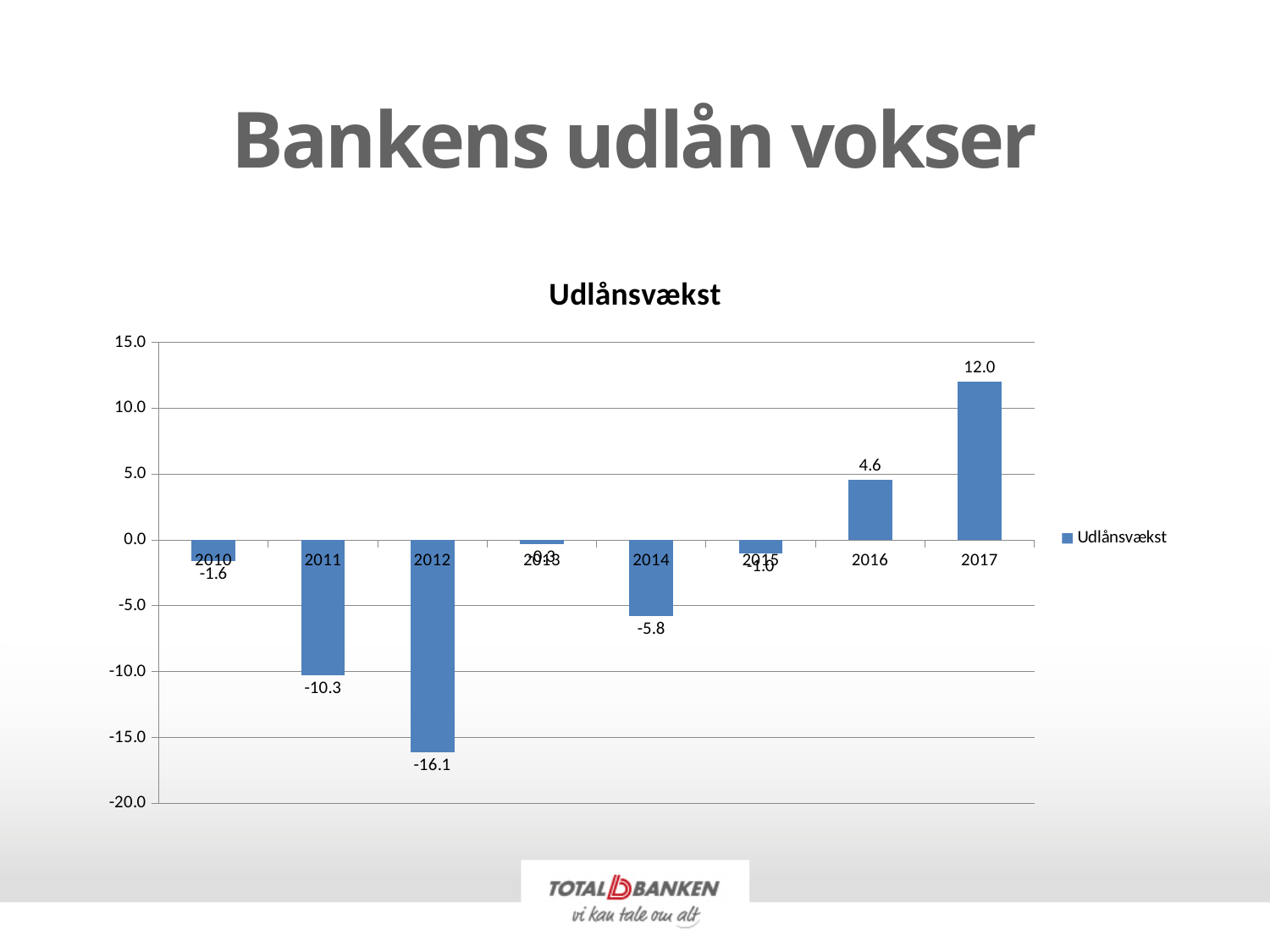
What is the difference between the values for 2017 and 2016 in the Udlånsvækst chart? 7.4 What is the value for 2012 in the Udlånsvækst chart? -16.1 Is the value for 2015 in the Udlånsvækst chart greater or less than -5.0? greater What is the value for 2017 in the Udlånsvækst chart? 12.0 Which year has the lowest value in the Udlånsvækst chart? 2012 Which is larger in the Udlånsvækst chart, the value for 2011 or the value for 2014? 2014 How many years are shown on the x axis of the Udlånsvækst chart? 8 What is the value for 2014 in the Udlånsvækst chart? -5.8 Which year has the highest value in the Udlånsvækst chart? 2017 What kind of chart is the Udlånsvækst chart? Bar chart What is the value for 2011 in the Udlånsvækst chart? -10.3 What is the value for 2016 in the Udlånsvækst chart? 4.6